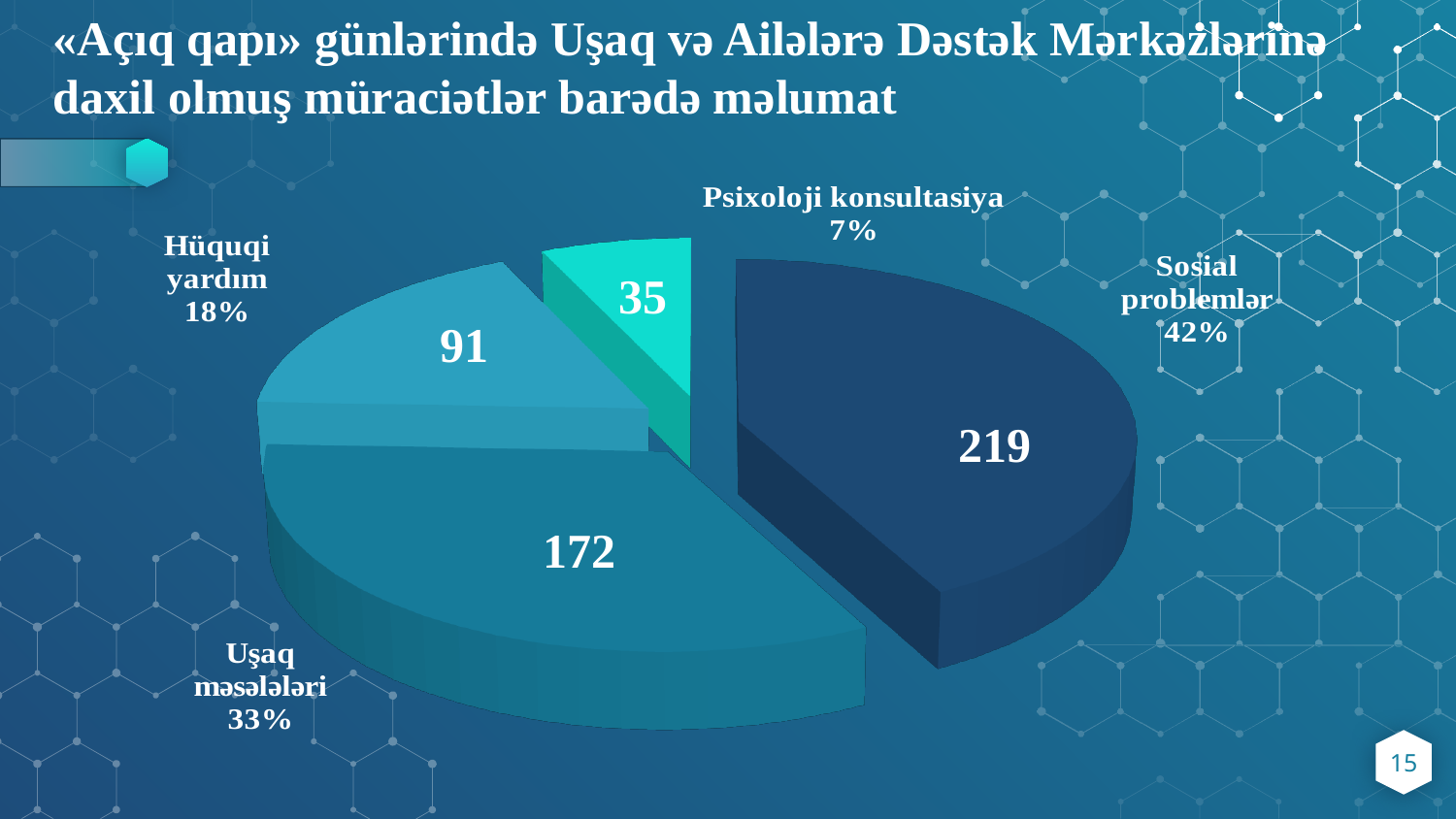
What is the value for Psixoloji konsultasiya? 35 Which category has the smallest slice of the pie? Psixoloji konsultasiya What share of the pie does Uşaq məsələləri represent? 33% How many slices does the pie chart have? 4 What is the difference between the values for Sosial problemlər and Uşaq məsələləri? 47 Which category has the largest slice of the pie? Sosial problemlər What is the value for Uşaq məsələləri? 172 What share of the pie does Hüquqi yardım represent? 18% Which is larger, the value for Hüquqi yardım or the value for Psixoloji konsultasiya? Hüquqi yardım What is the value for Hüquqi yardım? 91 What kind of chart is shown on the slide? pie chart What is the value for Sosial problemlər? 219